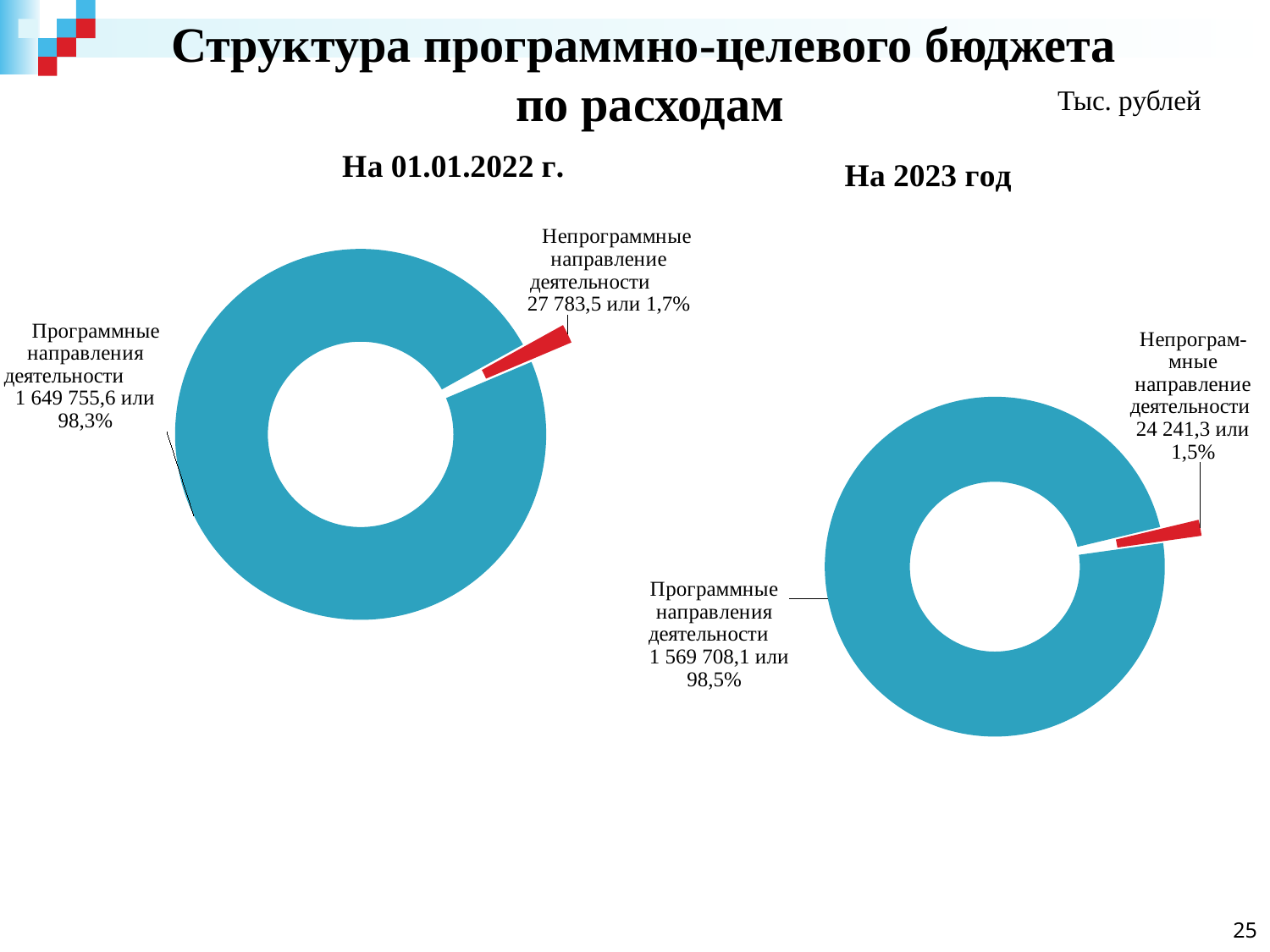
Which is larger: Непрограммные направление деятельности in the chart "На 01.01.2022 г." or in the chart "На 2023 год"? На 01.01.2022 г. How many categories does the chart titled "На 2023 год" show? 2 In the chart titled "На 2023 год", what is the value for Непрограммные направление деятельности? 24 241,3 What kind of chart is the chart titled "На 01.01.2022 г."? Doughnut (pie) chart In the chart titled "На 01.01.2022 г.", which category has the largest value? Программные направления деятельности In the chart titled "На 2023 год", what share of the total does Программные направления деятельности represent? 98,5% In the chart titled "На 2023 год", what is the value for Программные направления деятельности? 1 569 708,1 In the chart titled "На 01.01.2022 г.", what is the difference between Программные направления деятельности and Непрограммные направление деятельности? 1 621 972,1 In the chart titled "На 01.01.2022 г.", what is the value for Непрограммные направление деятельности? 27 783,5 In the chart titled "На 2023 год", which category has the smallest value? Непрограммные направление деятельности In the chart titled "На 01.01.2022 г.", what is the value for Программные направления деятельности? 1 649 755,6 In the chart titled "На 01.01.2022 г.", what share of the total does Непрограммные направление деятельности represent? 1,7%